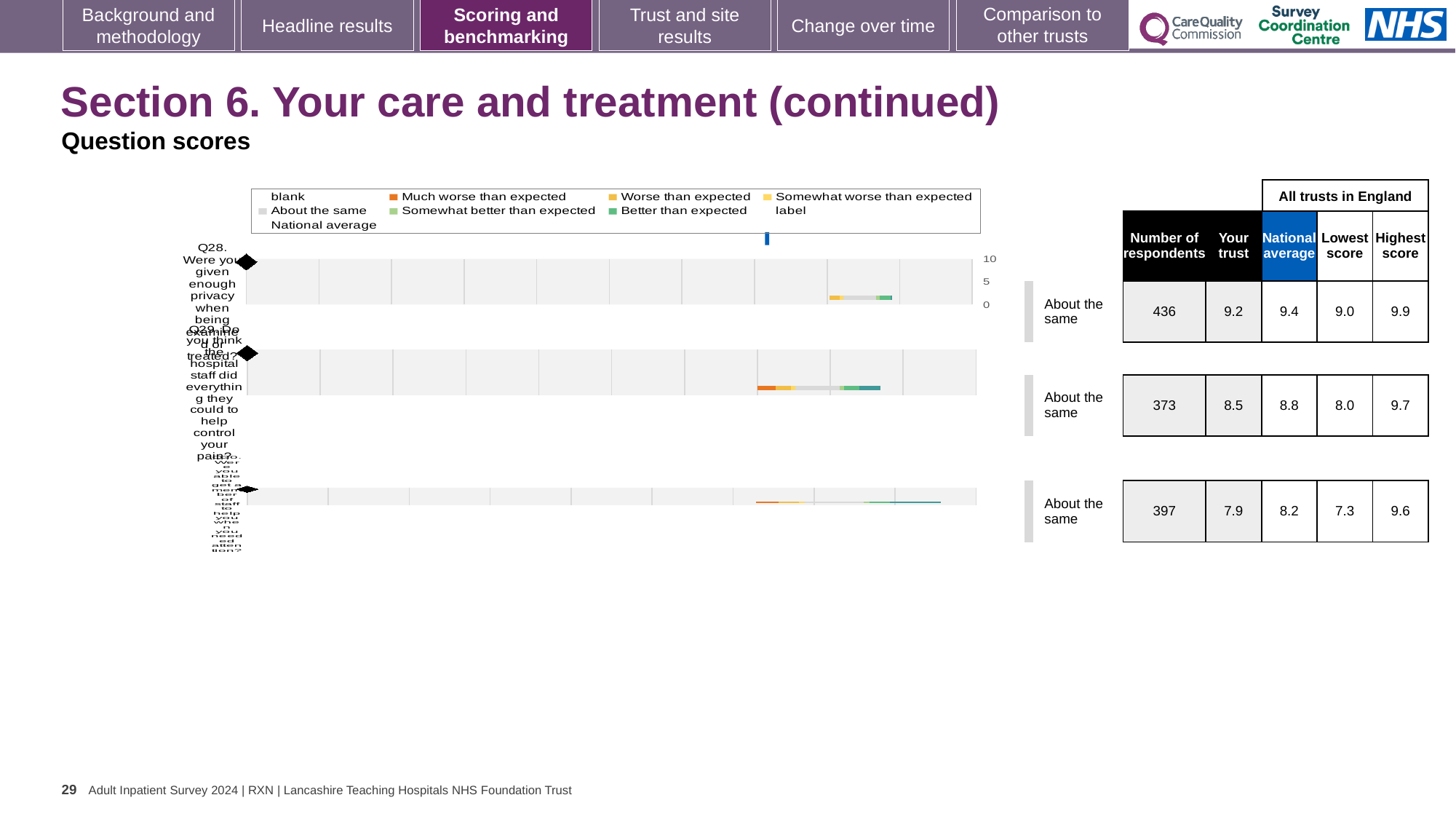
Which question has the highest 'Your trust' score? Q28 What is the 'Your trust' score for Q28 (Were you given enough privacy when being examined or treated?)? 9.2 What is the lowest score across all trusts in England for Q30? 7.3 For Q29, which is larger: the 'Your trust' score or the national average? National average How many questions are plotted on the slide? 3 How many respondents answered Q30 (Were you able to get a member of staff to help you when you needed attention?)? 397 What kind of chart is used to show the question scores on this slide? bar chart What is the national average score for Q29 (Do you think the hospital staff did everything they could to help control your pain?)? 8.8 Which question has the lowest 'Your trust' score? Q30 For Q28, what is the difference between the highest score and the lowest score across all trusts in England? 0.9 For Q30, how much higher is the national average than the 'Your trust' score? 0.3 What benchmark category is shown next to the Q28 bar? About the same